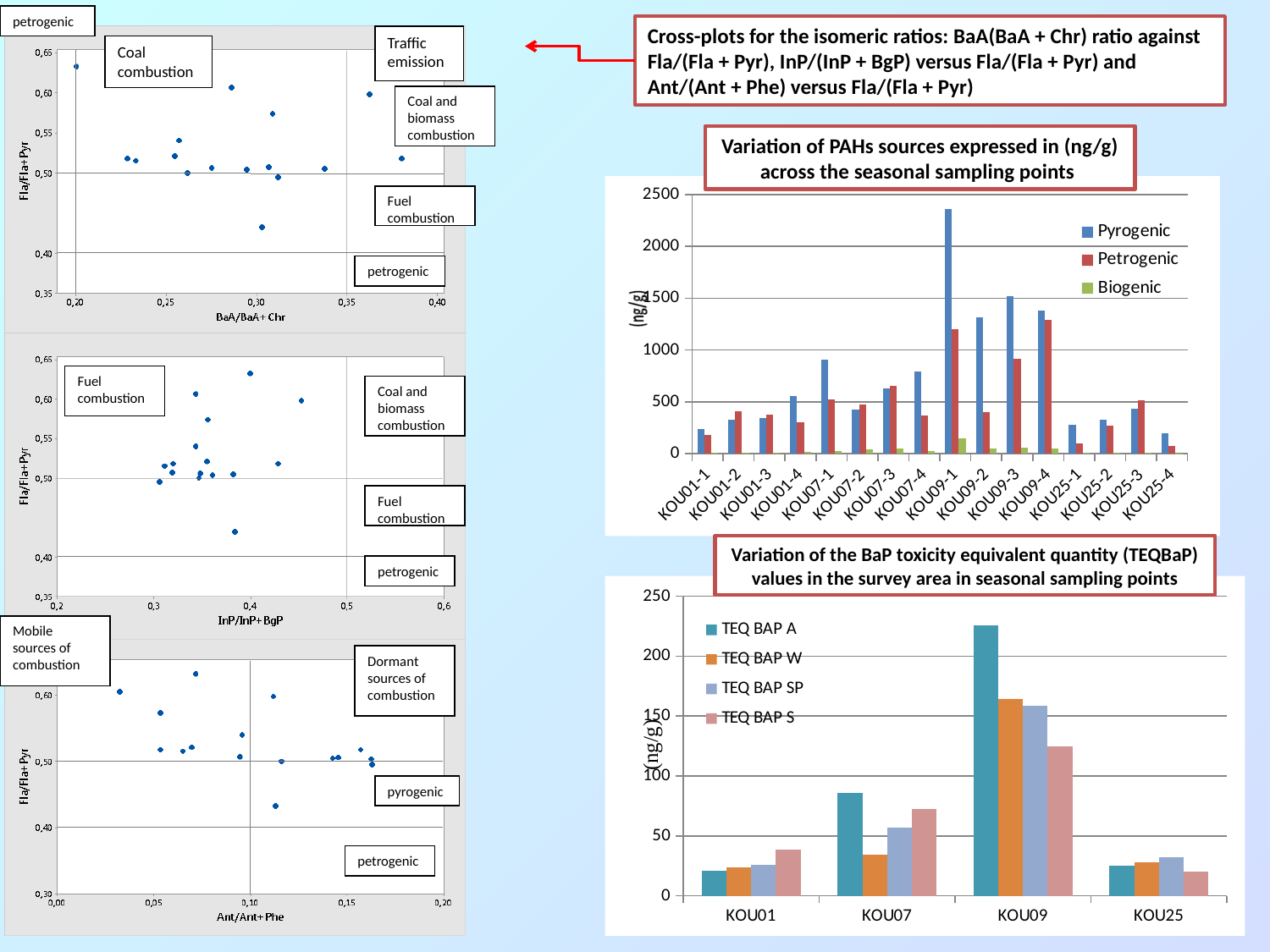
In the chart titled 'Variation of the BaP toxicity equivalent quantity (TEQBaP) values in the survey area in seasonal sampling points', is the TEQ BAP A value for KOU07 greater or less than 100? less What kind of chart is the top-left chart with BaA/BaA+Chr on the x axis? Scatter plot In the chart titled 'Variation of the BaP toxicity equivalent quantity (TEQBaP) values in the survey area in seasonal sampling points', which sampling point has the highest TEQ BAP A value? KOU09 In the chart titled 'Variation of PAHs sources expressed in (ng/g) across the seasonal sampling points', how many series does the legend list? 3 In the chart titled 'Variation of PAHs sources expressed in (ng/g) across the seasonal sampling points', which is larger at KOU07-4: the Pyrogenic value or the Petrogenic value? Pyrogenic In the chart titled 'Variation of PAHs sources expressed in (ng/g) across the seasonal sampling points', which sampling point has the highest Pyrogenic value? KOU09-1 In the chart titled 'Variation of the BaP toxicity equivalent quantity (TEQBaP) values in the survey area in seasonal sampling points', is the TEQ BAP A value for KOU09 greater or less than 200? greater In the chart titled 'Variation of the BaP toxicity equivalent quantity (TEQBaP) values in the survey area in seasonal sampling points', how many series does the legend list? 4 In the chart titled 'Variation of PAHs sources expressed in (ng/g) across the seasonal sampling points', is the Pyrogenic value for KOU25-4 greater or less than 500? less In the chart titled 'Variation of the BaP toxicity equivalent quantity (TEQBaP) values in the survey area in seasonal sampling points', which series has the lowest value at KOU25? TEQ BAP S In the chart titled 'Variation of PAHs sources expressed in (ng/g) across the seasonal sampling points', how many sampling points are shown on the x axis? 16